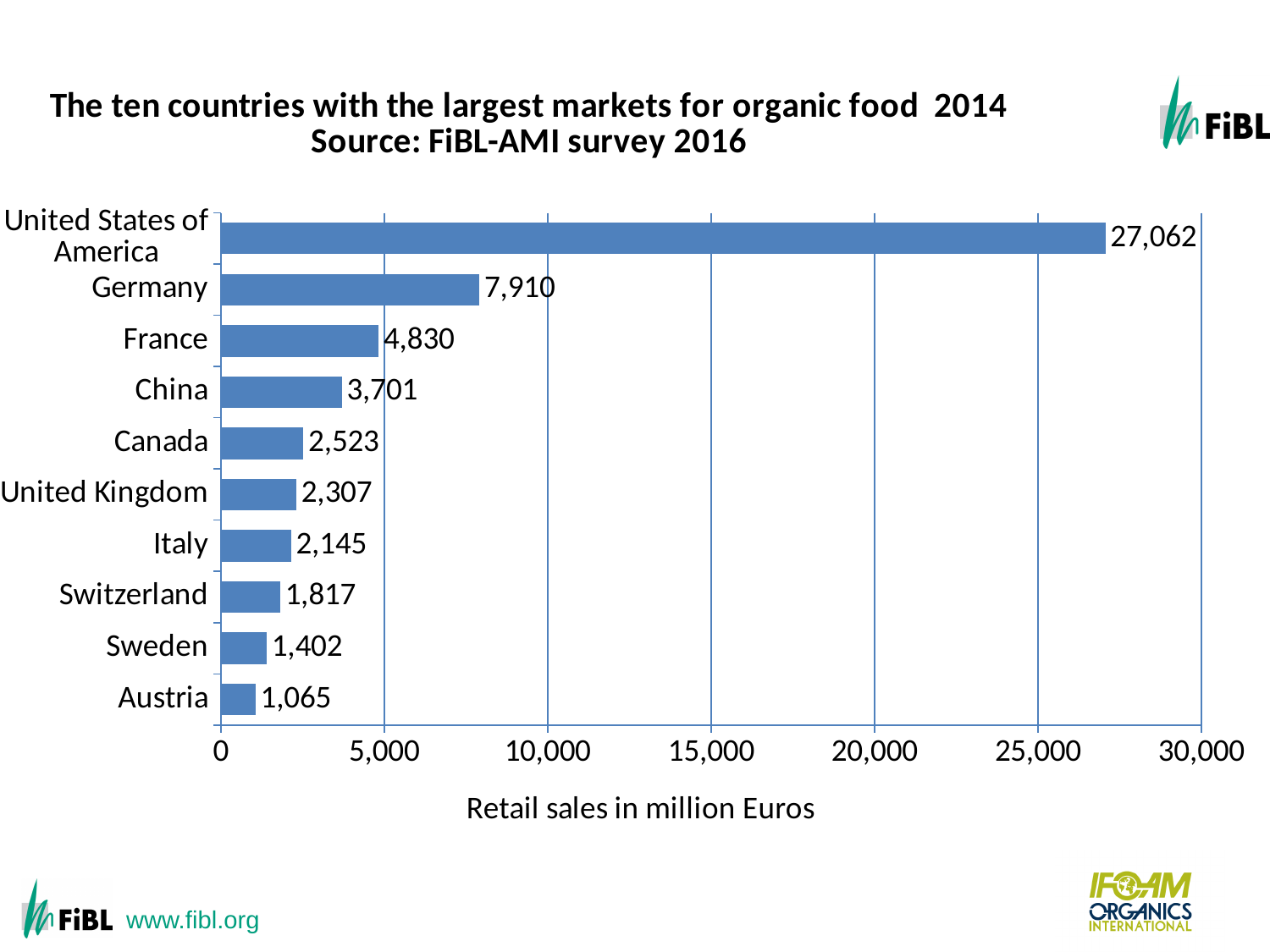
Which has a larger value, the United Kingdom or Italy? United Kingdom Which country has the largest market for organic food on this chart? United States of America What is the retail sales value for Germany? 7,910 What is the difference between the values for France and China? 1,129 Is the value for Germany greater or less than 5,000? greater What is the difference between the values for the United States of America and Germany? 19,152 What kind of chart is shown on the slide? bar chart What is the retail sales value for Canada? 2,523 Which country has the smallest value on this chart? Austria How many countries are shown on the chart? 10 What is the label of the horizontal axis? Retail sales in million Euros What is the retail sales value for Switzerland? 1,817